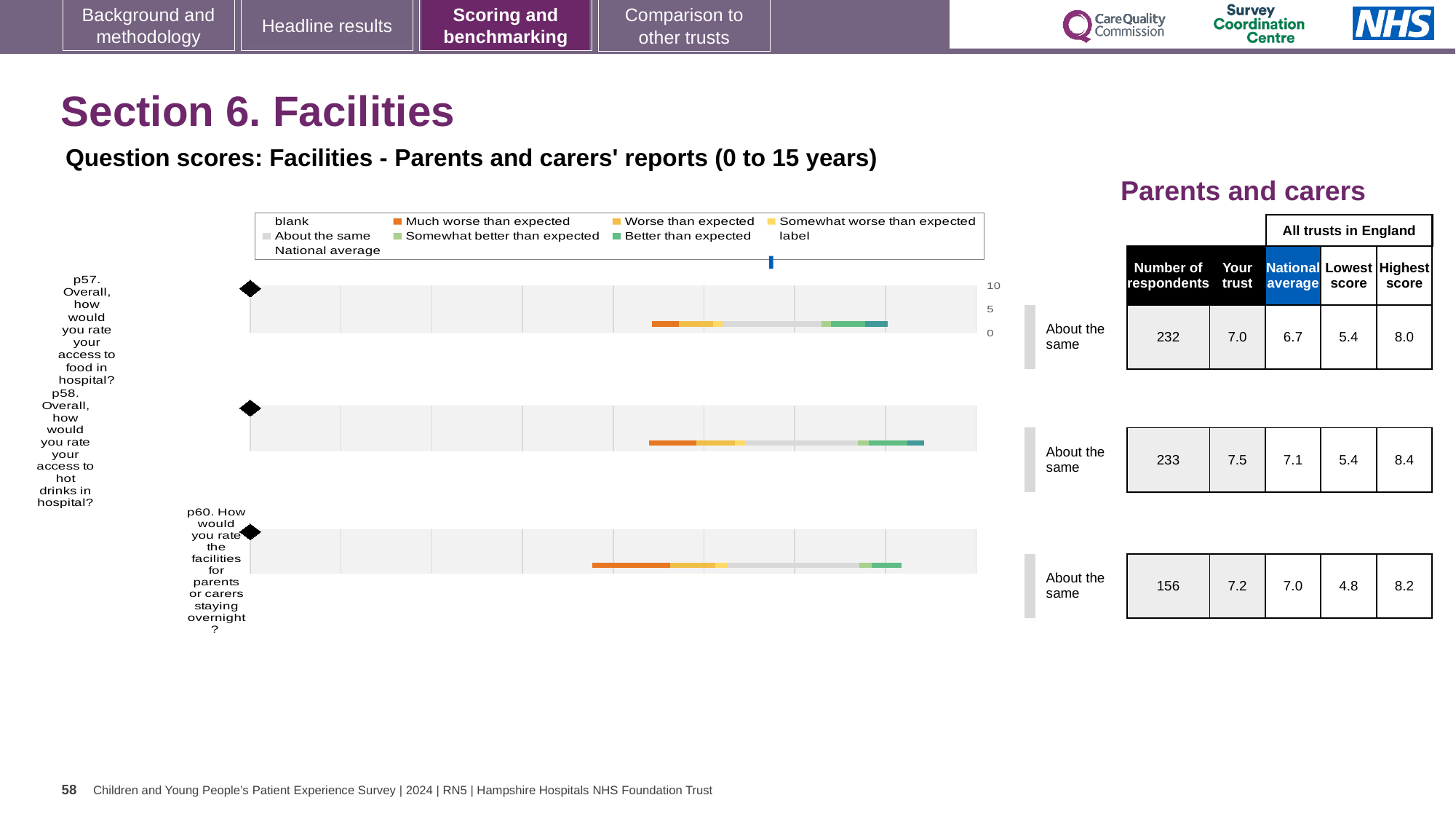
How many respondents are listed for p60 (facilities for parents or carers staying overnight)? 156 How many questions (charts) are plotted on the slide? 3 Which question has the fewest respondents? p60. How would you rate the facilities for parents or carers staying overnight? Which question has the highest 'Your trust' score? p58. Overall, how would you rate your access to hot drinks in hospital? What is the difference between the highest and lowest scores across all trusts in England for p60? 3.4 What kind of chart is used to show the question scores on this slide? bar chart For p58 (access to hot drinks in hospital), what is the national average score? 7.1 For p58, which is larger: the 'Your trust' score or the national average? Your trust What is the difference between the 'Your trust' score and the national average for p58? 0.4 What is the highest score across all trusts in England for p58? 8.4 For p57 (access to food in hospital), what is the 'Your trust' score shown in the table? 7.0 What benchmark category is shown next to each of the three question charts? About the same